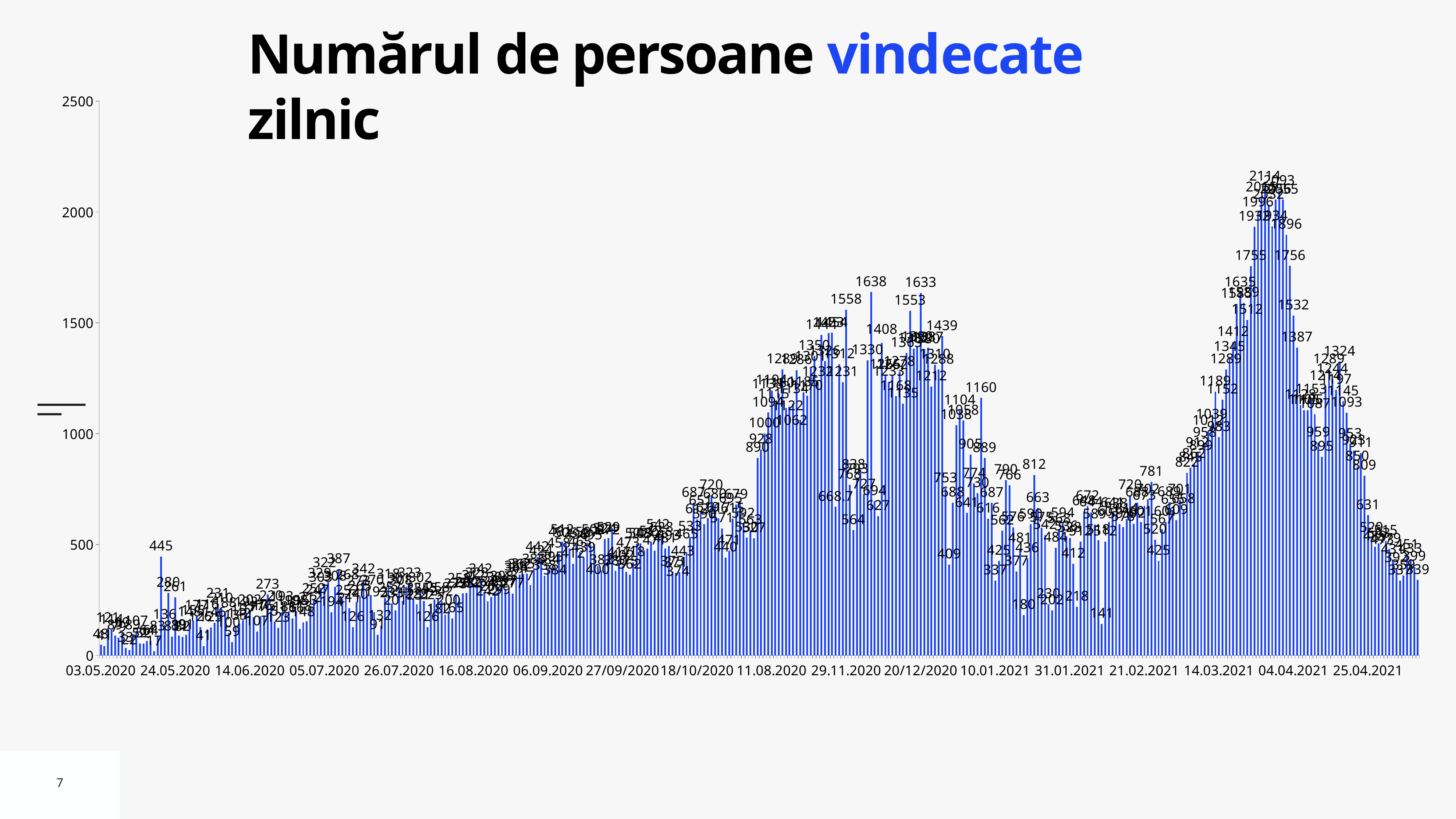
Is the value of the first bar at 03.05.2020 greater or less than 500? less Is the tallest bar near 04.04.2021 greater or less than 2000? greater What kind of chart is shown on the slide? bar chart Is the value of the bar at 25.04.2021 greater or less than 1000? less What is the title of the chart? Numărul de persoane vindecate zilnic What is the difference between the peak value 2114 and the peak value 1638? 476 What is the value of the tallest bar in May 2020, near 24.05.2020? 445 What is the value of the tallest bar near 29.11.2020? 1638 How many date labels are shown on the x axis? 18 What is the highest value labelled on the chart? 2114 What is the difference between the labelled values 1638 and 1633? 5 Do the values rise or fall from 04.04.2021 to the end of the chart? fall